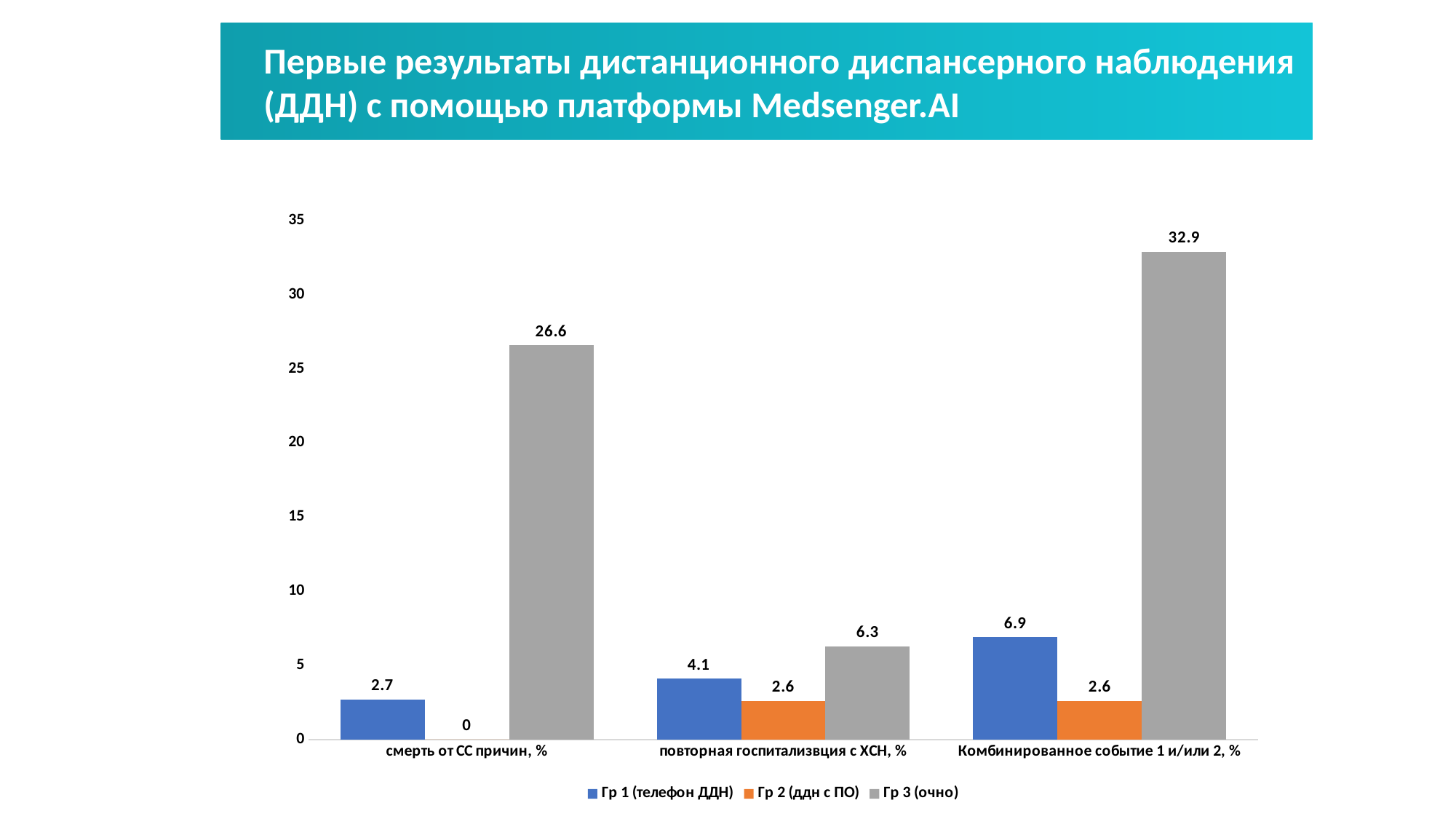
What is the value for Гр 3 (очно) in the category 'Комбинированное событие 1 и/или 2, %'? 32.9 What is the difference between the Гр 3 (очно) and Гр 1 (телефон ДДН) values in the category 'Комбинированное событие 1 и/или 2, %'? 26.0 Which is larger: the Гр 1 (телефон ДДН) value for 'смерть от СС причин, %' or the Гр 1 (телефон ДДН) value for 'Комбинированное событие 1 и/или 2, %'? Комбинированное событие 1 и/или 2, % What is the value for Гр 3 (очно) in the category 'смерть от СС причин, %'? 26.6 What is the difference between the Гр 1 (телефон ДДН) and Гр 2 (ддн с ПО) values in the category 'повторная госпитализвция с ХСН, %'? 1.5 What is the value for Гр 2 (ддн с ПО) in the category 'смерть от СС причин, %'? 0 How many categories are shown on the x axis? 3 Which series has the highest value in the category 'Комбинированное событие 1 и/или 2, %'? Гр 3 (очно) How many series does the legend list? 3 What is the value for Гр 1 (телефон ДДН) in the category 'повторная госпитализвция с ХСН, %'? 4.1 What kind of chart is shown on the slide? Bar chart Which series has the lowest value in the category 'смерть от СС причин, %'? Гр 2 (ддн с ПО)